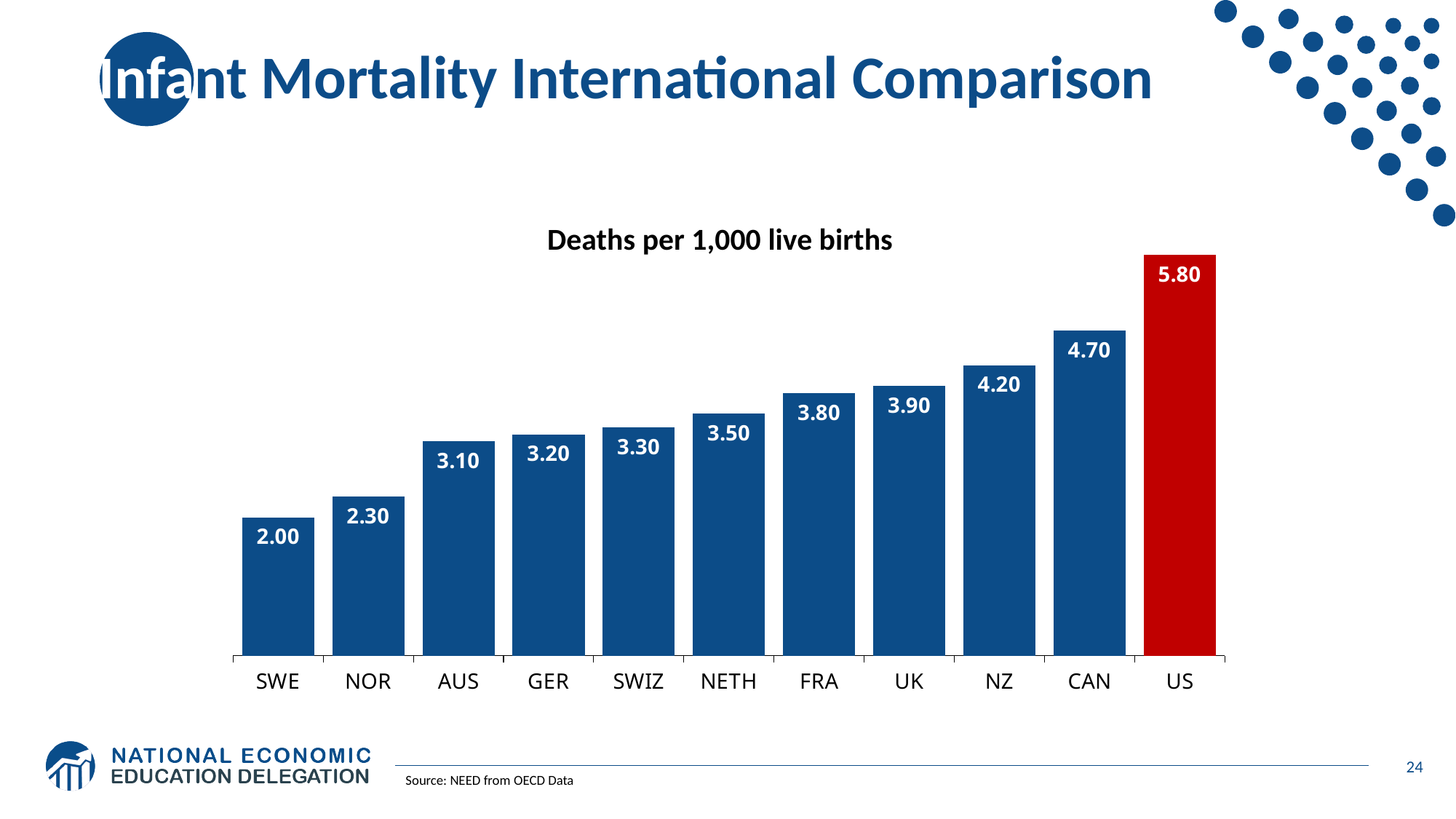
Which country has the highest value? US What is the difference between the values for NOR and SWE? 0.30 Which is larger, the value for FRA or the value for GER? FRA What is the value for NETH? 3.50 How many countries are shown on the chart? 11 What is the title of the chart? Deaths per 1,000 live births Which country has the lowest value? SWE What is the difference between the values for the US and CAN? 1.10 What is the value for SWE? 2.00 What is the value for the US? 5.80 Do the values rise or fall from left to right along the x axis? rise What kind of chart is this? bar chart